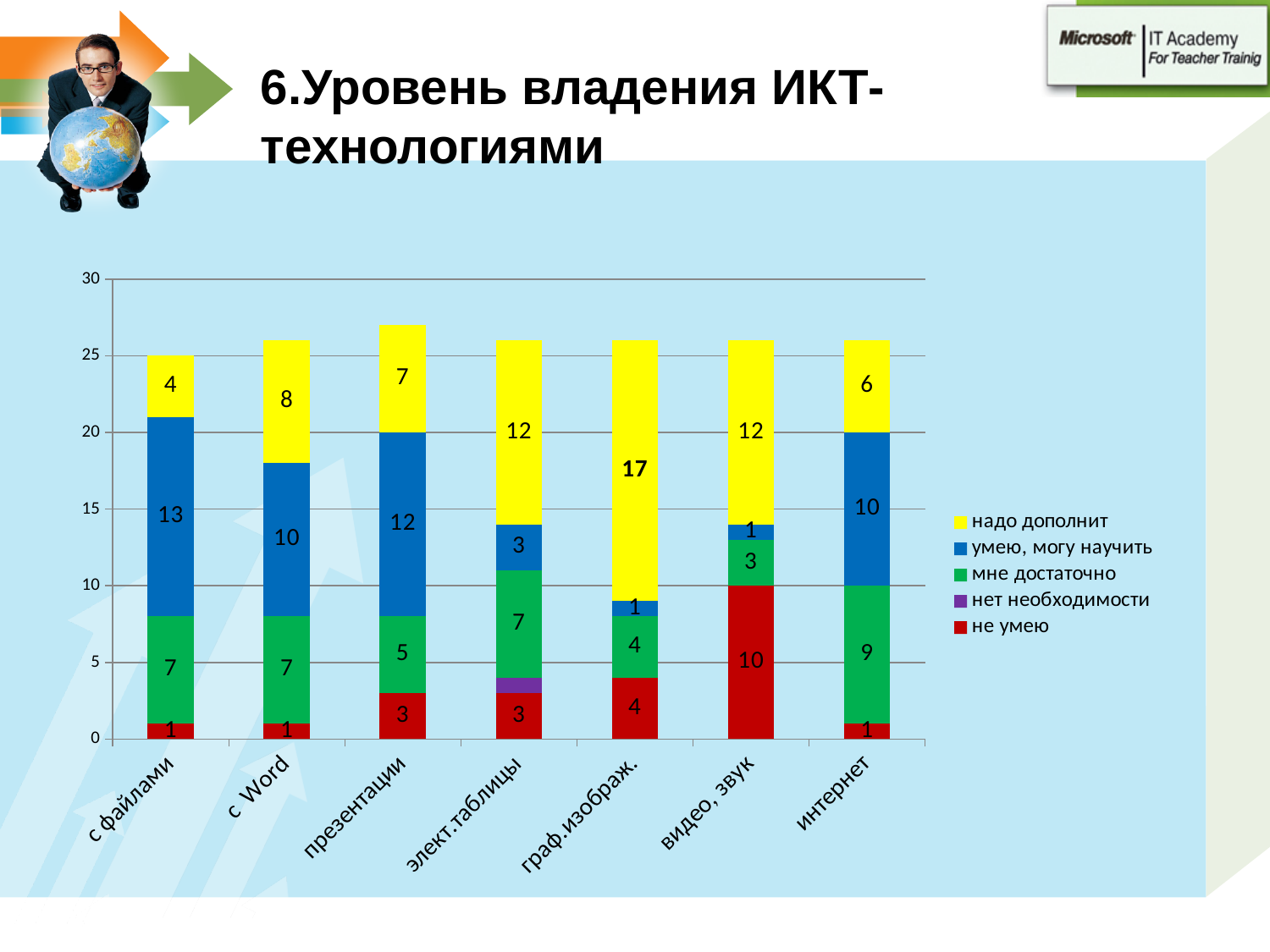
How many series does the chart's legend list? 5 How many categories are shown along the x axis of the chart? 7 What is the value of 'умею, могу научить' for 'с файлами'? 13 What kind of chart is shown on the slide? stacked bar chart What is the total of the stacked bar for 'презентации'? 27 What is the total of the stacked bar for 'с файлами'? 25 Which category has the highest value for 'умею, могу научить'? с файлами Which has the larger 'мне достаточно' value, 'интернет' or 'презентации'? интернет What is the difference between the 'надо дополнит' values for 'с Word' and 'с файлами'? 4 What is the value of 'не умею' for 'видео, звук'? 10 Which category has the highest value for 'надо дополнит'? граф.изображ. What is the value of 'надо дополнит' for 'граф.изображ.'? 17